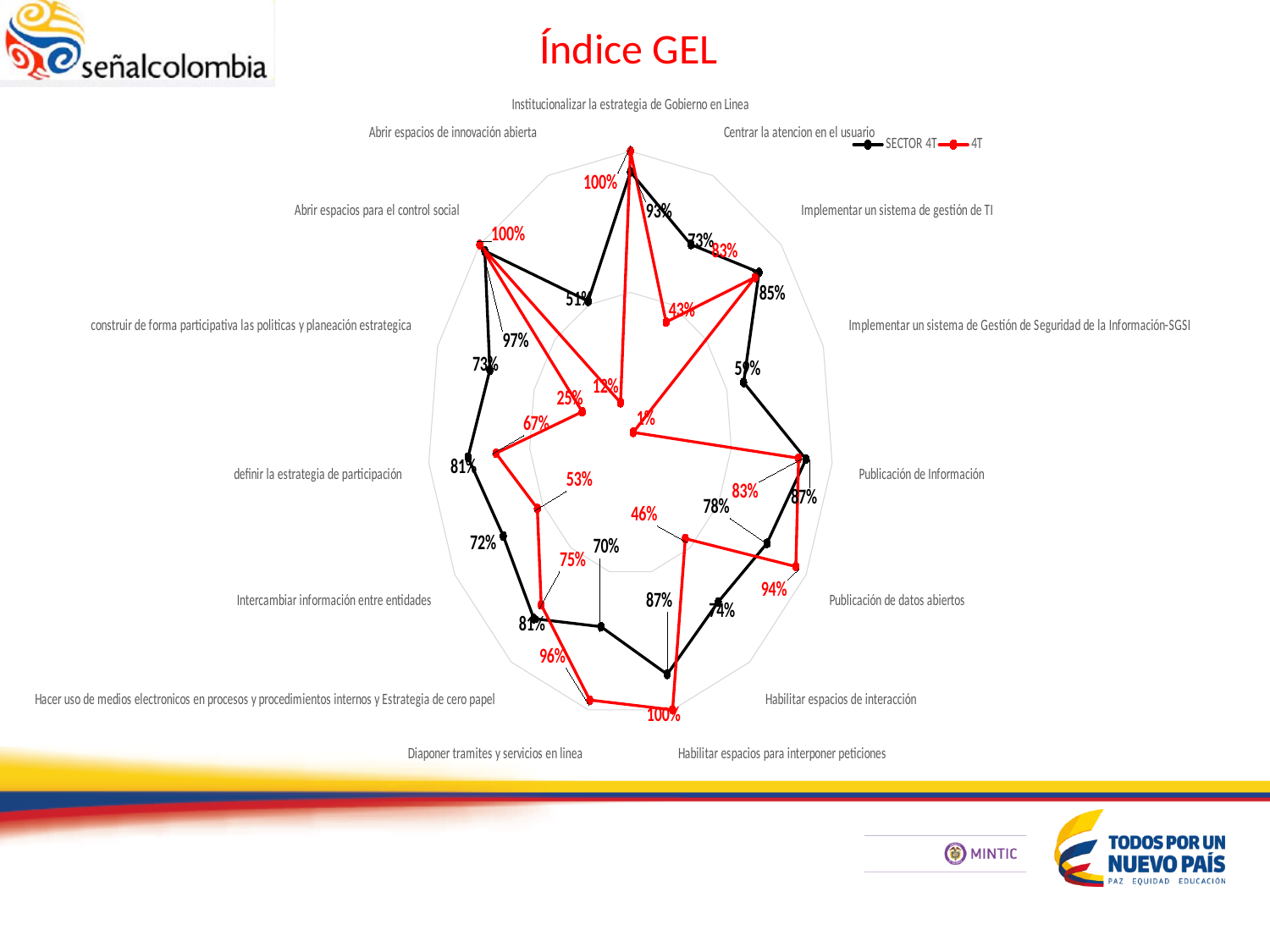
For 'Disponer tramites y servicios en linea', which series has the larger value, SECTOR 4T (70%) or 4T (96%)? 4T What is the 4T value for 'Publicación de datos abiertos'? 94% What is the title of the chart? Índice GEL What is the SECTOR 4T value for 'Implementar un sistema de Gestión de Seguridad de la Información-SGSI'? 59% How many categories (axes) does the radar chart have? 15 What is the SECTOR 4T value for 'Institucionalizar la estrategia de Gobierno en Linea'? 93% What are the two series named in the legend? SECTOR 4T and 4T What is the 4T value for 'Institucionalizar la estrategia de Gobierno en Linea'? 100% Which category has the lowest SECTOR 4T value? Abrir espacios de innovación abierta What kind of chart is shown on the slide? Radar chart What is the SECTOR 4T value for 'Disponer tramites y servicios en linea'? 70% How many series does the legend list? 2